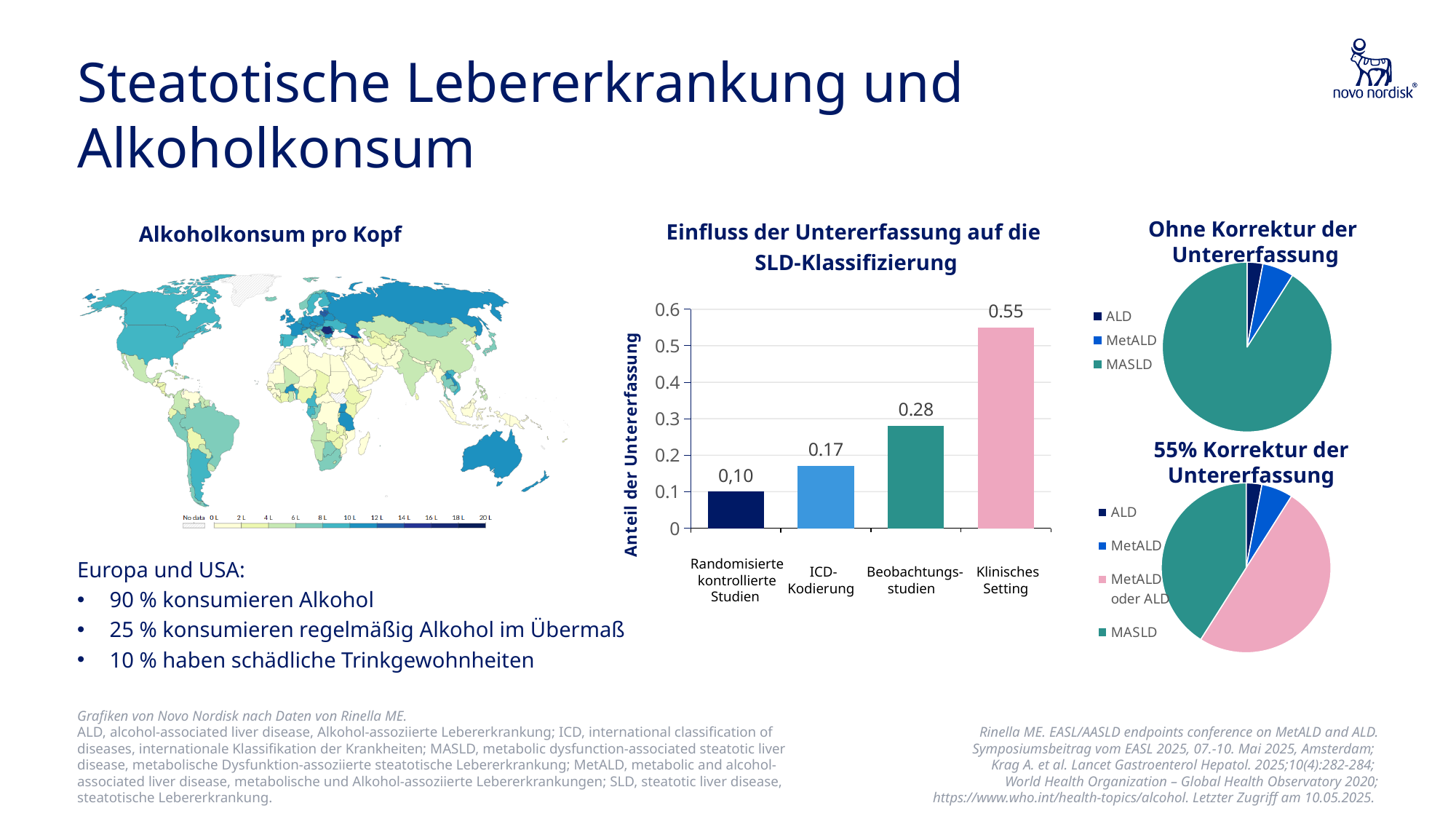
In the pie chart 'Ohne Korrektur der Untererfassung', which category has the largest slice? MASLD In the bar chart 'Einfluss der Untererfassung auf die SLD-Klassifizierung', what is the value for ICD-Kodierung? 0.17 In the bar chart 'Einfluss der Untererfassung auf die SLD-Klassifizierung', which category has the lowest value? Randomisierte kontrollierte Studien How many categories does the legend of the pie chart '55% Korrektur der Untererfassung' list? 4 In the bar chart 'Einfluss der Untererfassung auf die SLD-Klassifizierung', which is larger: the value for ICD-Kodierung or for Beobachtungsstudien? Beobachtungsstudien In the bar chart 'Einfluss der Untererfassung auf die SLD-Klassifizierung', what is the value for Klinisches Setting? 0.55 Do the values in the bar chart 'Einfluss der Untererfassung auf die SLD-Klassifizierung' rise or fall from left to right? rise In the bar chart 'Einfluss der Untererfassung auf die SLD-Klassifizierung', what is the value for Beobachtungsstudien? 0.28 How many bars are shown in the bar chart 'Einfluss der Untererfassung auf die SLD-Klassifizierung'? 4 In the bar chart 'Einfluss der Untererfassung auf die SLD-Klassifizierung', what is the difference between the values for Klinisches Setting and Beobachtungsstudien? 0.27 In the bar chart 'Einfluss der Untererfassung auf die SLD-Klassifizierung', what is the value for Randomisierte kontrollierte Studien? 0,10 In the bar chart 'Einfluss der Untererfassung auf die SLD-Klassifizierung', which category has the highest value? Klinisches Setting